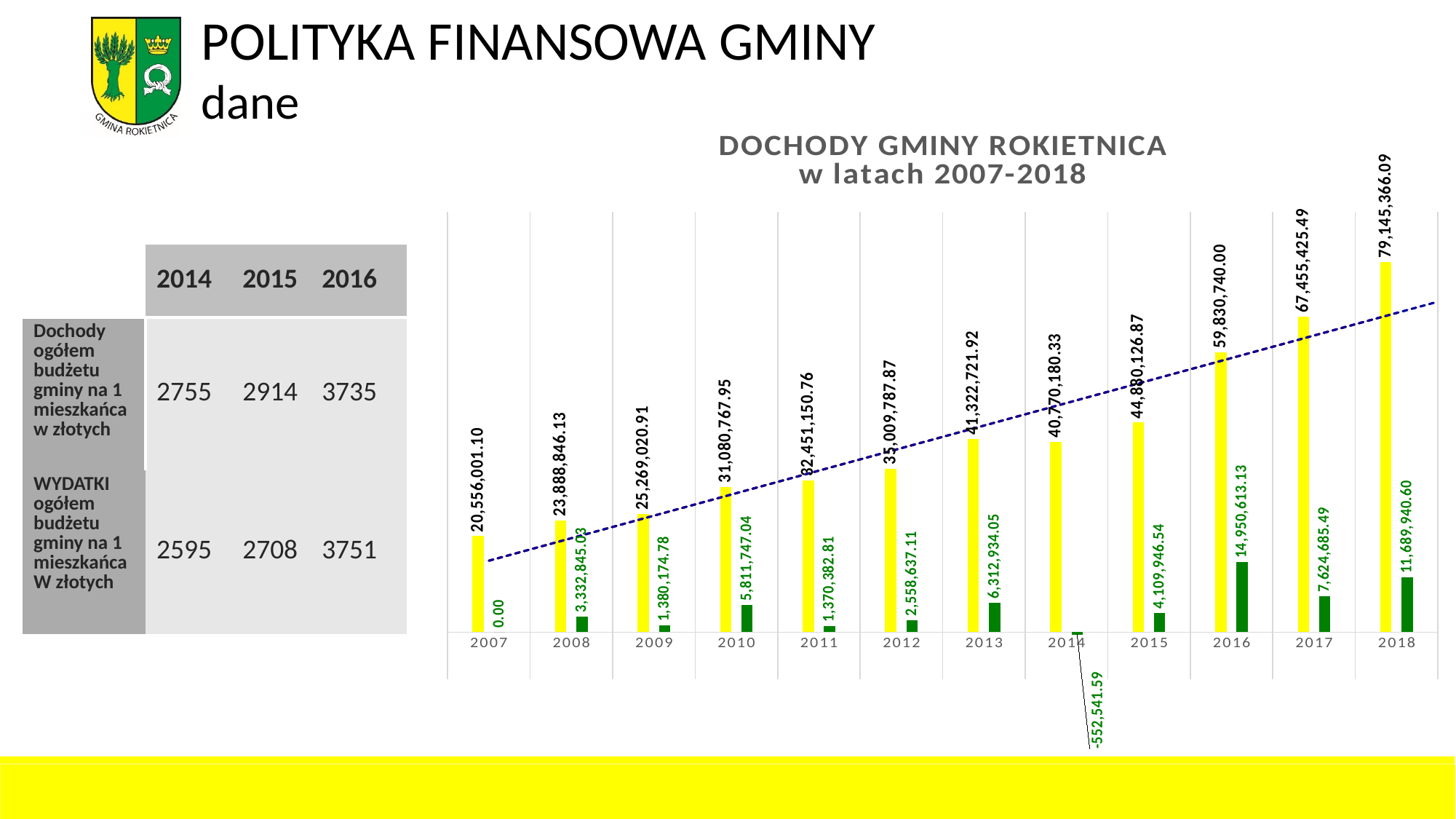
What is the value of the green bar for 2014? -552,541.59 Which year has the highest yellow bar? 2018 What is the title of the chart on the slide? DOCHODY GMINY ROKIETNICA w latach 2007-2018 What is the value of the yellow bar for 2007? 20,556,001.10 What type of chart is shown on the slide? bar chart Do the yellow bar values generally rise or fall from 2007 to 2018? rise How many years are shown along the x axis of the chart? 12 What is the value of the green bar for 2016? 14,950,613.13 Which year has the lowest green bar value? 2014 Which is larger, the yellow bar for 2013 or the yellow bar for 2014? 2013 What is the value of the yellow bar for 2018? 79,145,366.09 What is the difference between the yellow bar values for 2018 and 2017? 11,689,940.60